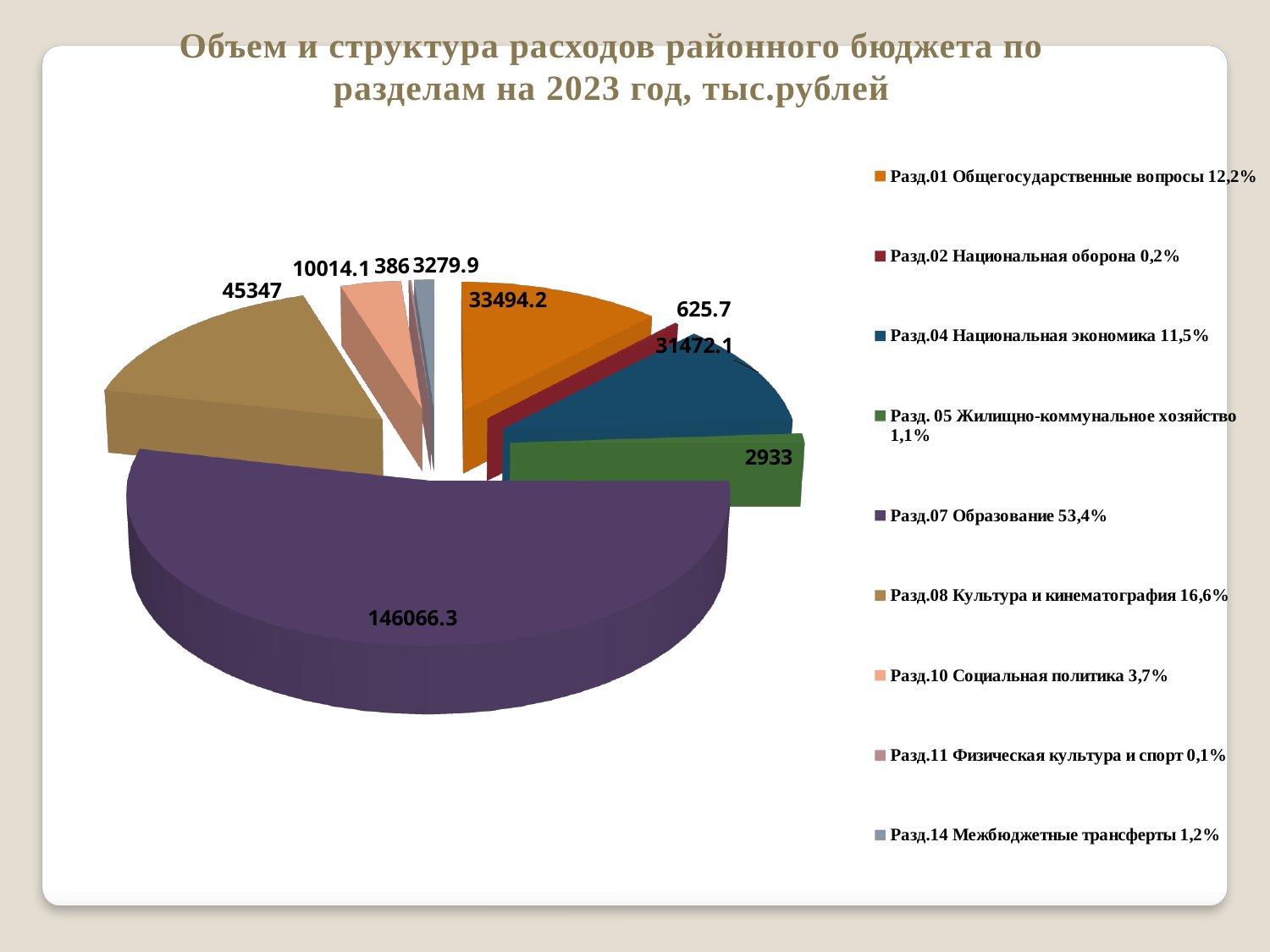
What is the value for Разд.07 Образование? 146066.3 How many sections (slices) does the pie chart show? 9 Which is larger: the value for Разд.14 Межбюджетные трансферты or Разд. 05 Жилищно-коммунальное хозяйство? Разд.14 Межбюджетные трансферты Which section has the largest share of the budget expenditures? Разд.07 Образование What share of the budget does Разд.08 Культура и кинематография account for, according to the legend? 16,6% What type of chart is shown on the slide? pie chart What is the difference between the values for Разд.01 Общегосударственные вопросы and Разд.04 Национальная экономика? 2022.1 What is the value for Разд.04 Национальная экономика? 31472.1 What is the value for Разд.08 Культура и кинематография? 45347 What is the value for Разд.10 Социальная политика? 10014.1 Which section has the smallest value? Разд.11 Физическая культура и спорт What is the value for Разд.01 Общегосударственные вопросы? 33494.2